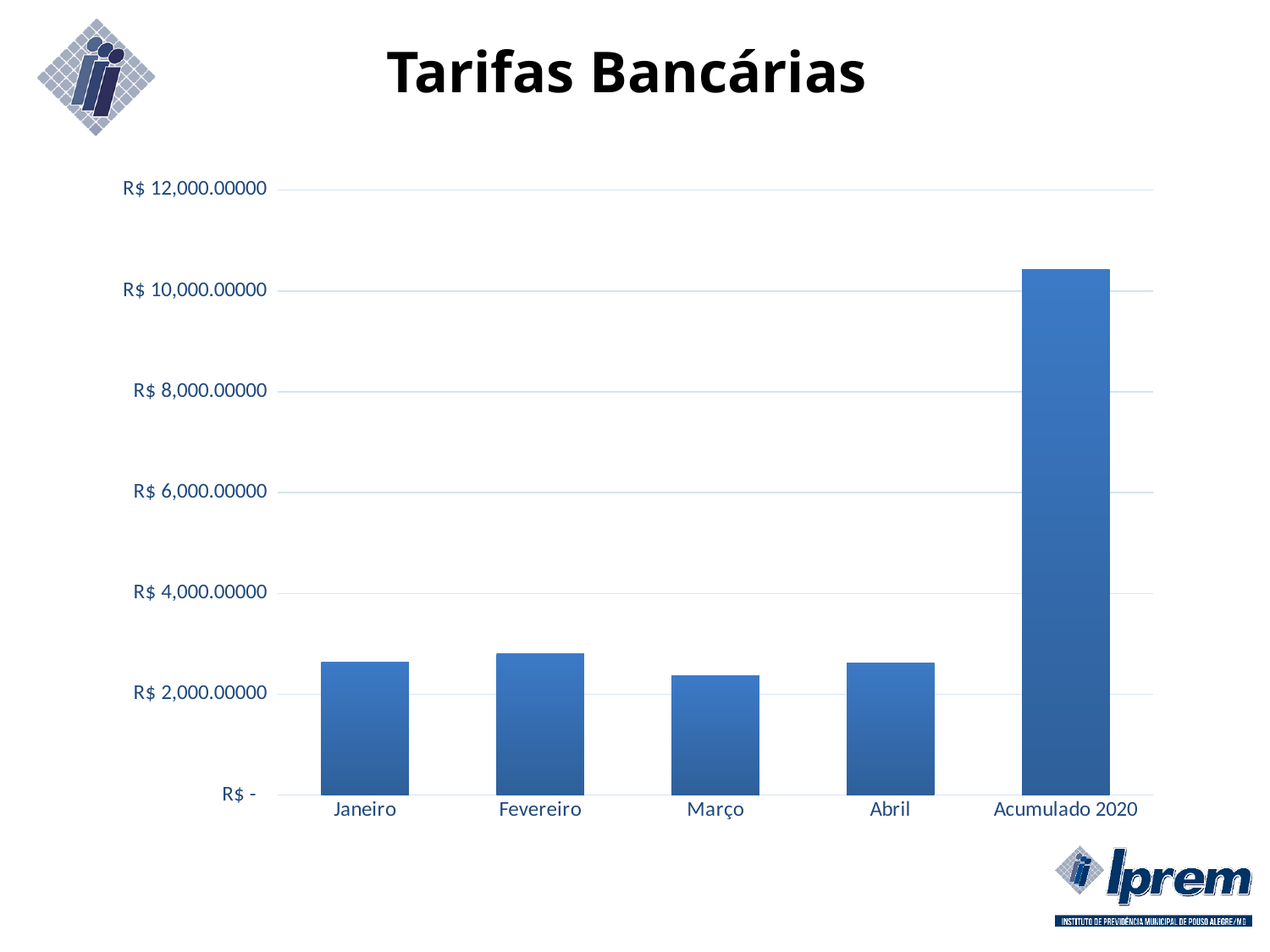
Which category has the lowest value in the chart? Março Is the value for Março greater or less than R$ 2,000.00000? greater Does the value rise or fall from Fevereiro to Março? fall Is the value for Fevereiro greater or less than R$ 4,000.00000? less Which category has the highest value in the chart? Acumulado 2020 What kind of chart is shown on the slide? bar chart How many categories are shown on the x axis of the chart? 5 Is the value for Janeiro greater or less than R$ 4,000.00000? less Which is larger, the value for Fevereiro or the value for Março? Fevereiro Which is larger, the value for Acumulado 2020 or the value for Abril? Acumulado 2020 What is the title of the chart? Tarifas Bancárias